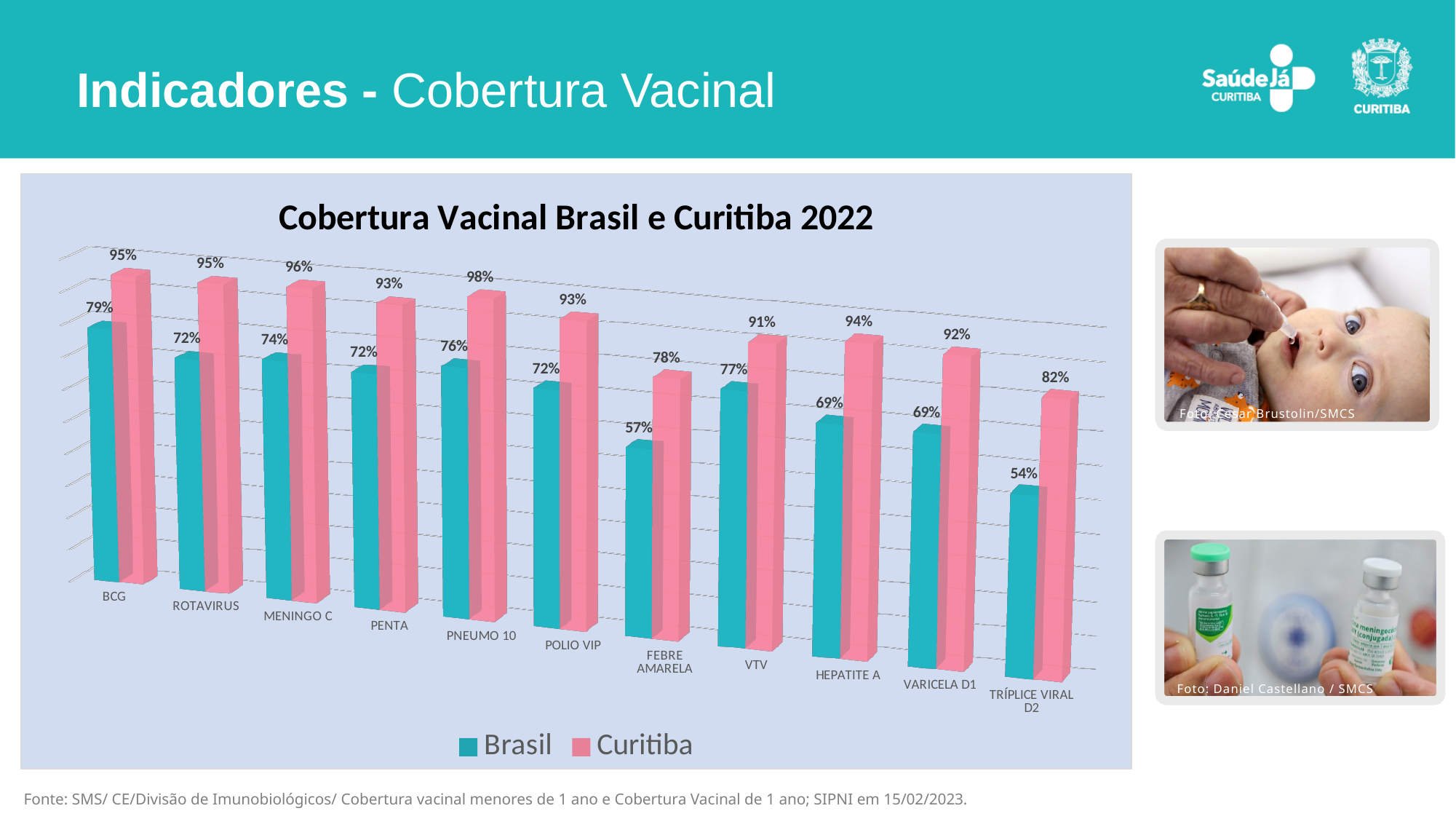
Which category has the highest Curitiba value? PNEUMO 10 What is the Brasil value for FEBRE AMARELA? 57% Which is larger, the Brasil value for VTV or the Brasil value for HEPATITE A? VTV Which category has the lowest Curitiba value? FEBRE AMARELA Which category has the lowest Brasil value? TRÍPLICE VIRAL D2 How many vaccine categories are shown on the x axis? 11 What is the Curitiba value for TRÍPLICE VIRAL D2? 82% What is the difference between the Curitiba and Brasil values for BCG? 16 percentage points What is the Curitiba value for PNEUMO 10? 98% How many series does the legend list? 2 What type of chart is shown on the slide? Bar chart What is the difference between the Curitiba and Brasil values for TRÍPLICE VIRAL D2? 28 percentage points